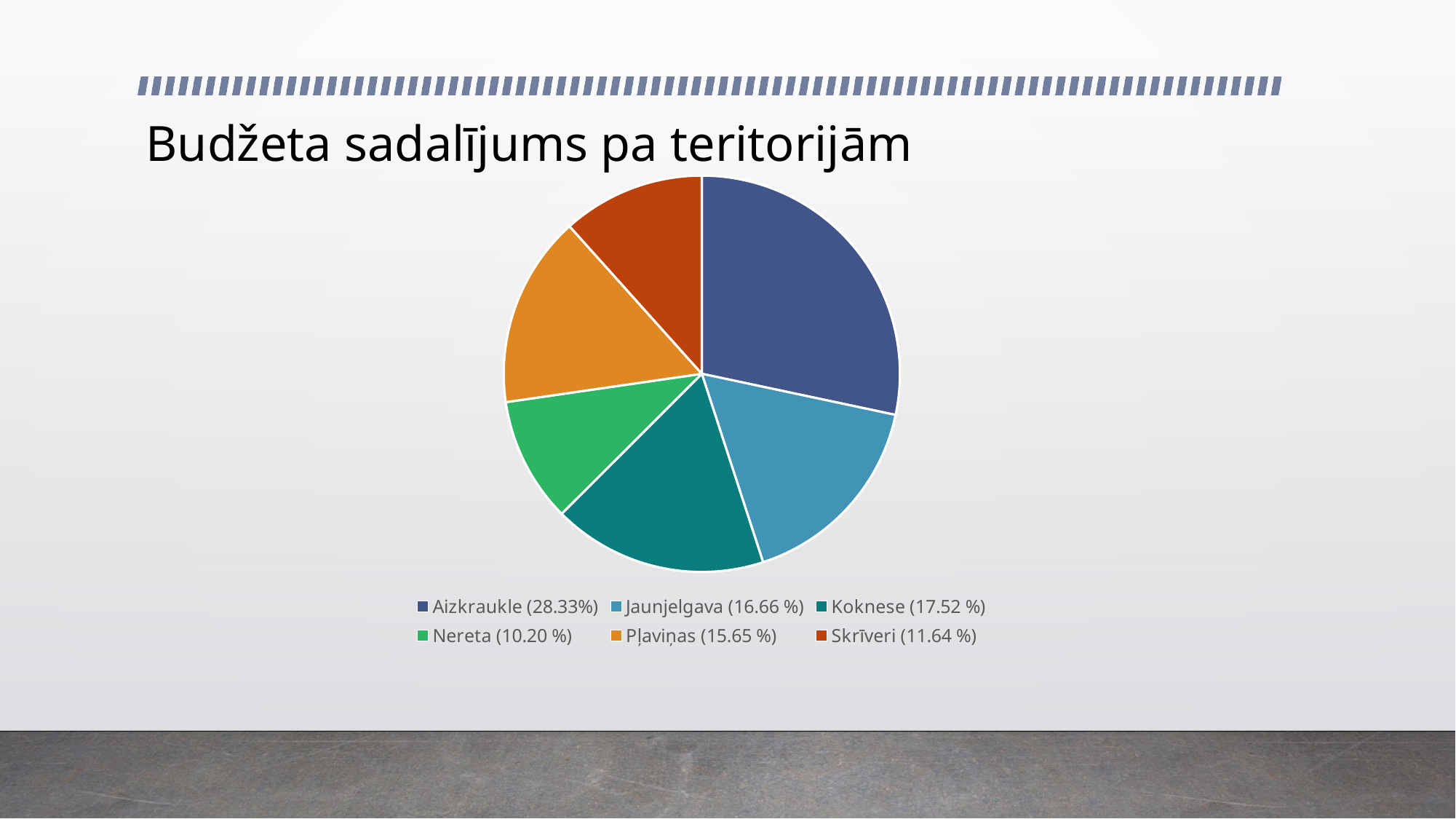
What share of the pie does Aizkraukle have? 28.33% What colour is the Skrīveri slice? dark orange-red Which territory has the smallest share of the budget? Nereta What is the difference in percentage points between Aizkraukle and Nereta? 18.13 Which territory has the largest share of the budget? Aizkraukle What is the title of the chart? Budžeta sadalījums pa teritorijām What share of the pie does Skrīveri have? 11.64 % What share of the pie does Nereta have? 10.20 % Which has the larger share, Koknese or Jaunjelgava? Koknese What kind of chart is shown on the slide? pie chart How many slices does the pie chart have? 6